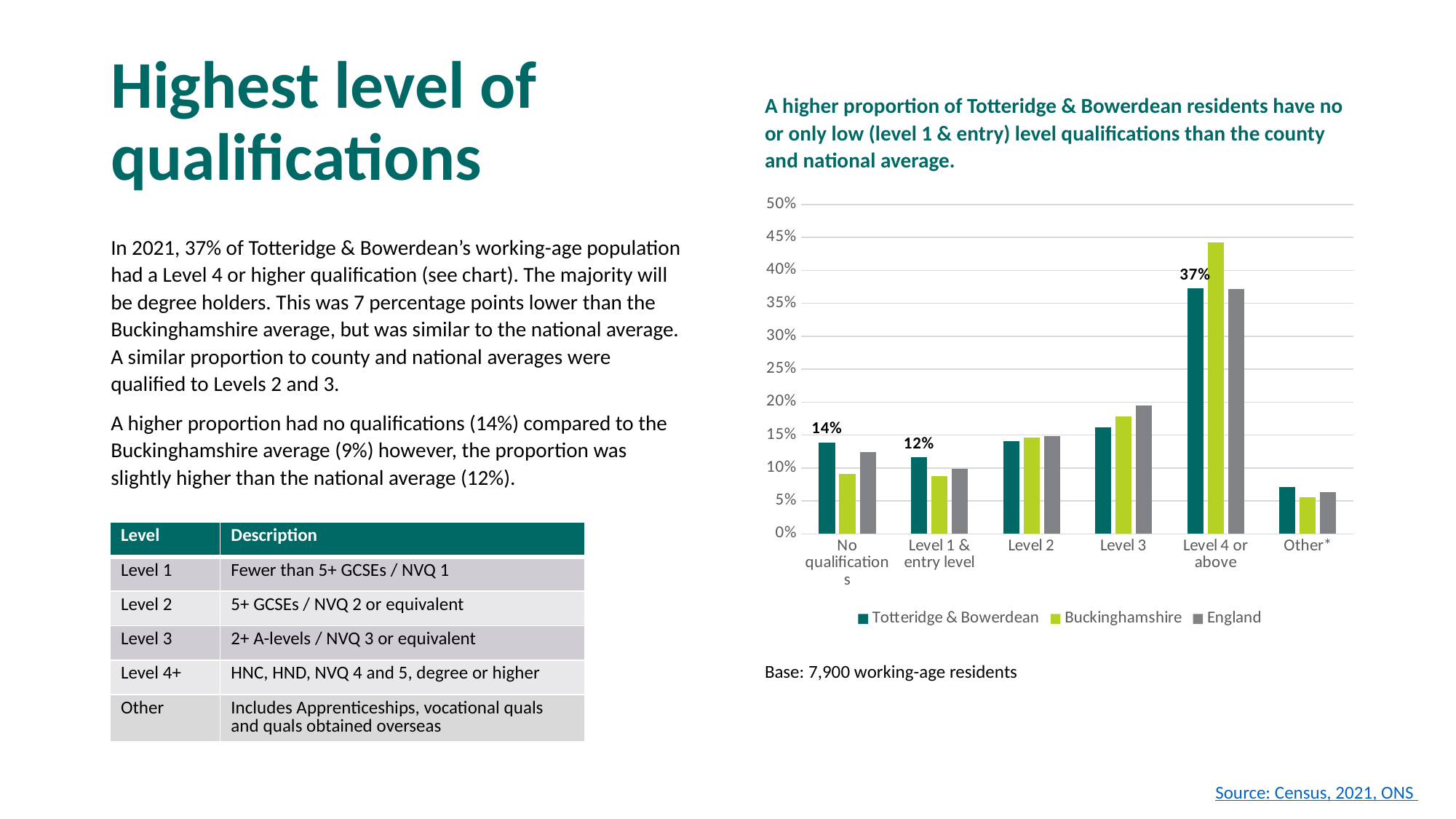
What is the value for Totteridge & Bowerdean in the Level 4 or above category? 37% In the Level 4 or above category, which is larger: Buckinghamshire or Totteridge & Bowerdean? Buckinghamshire What is the value for Totteridge & Bowerdean in the Level 1 & entry level category? 12% What is the difference in percentage points between Totteridge & Bowerdean's Level 4 or above value and its No qualifications value? 23 percentage points How many series does the chart legend list? 3 Is the value for Buckinghamshire in the Level 4 or above category greater or less than 40%? greater Which qualification category has the lowest value for Totteridge & Bowerdean? Other* In the No qualifications category, which is larger: Totteridge & Bowerdean or Buckinghamshire? Totteridge & Bowerdean What percentage of Totteridge & Bowerdean residents have no qualifications? 14% How many qualification categories are shown on the x axis of the chart? 6 Which qualification category has the highest value for Buckinghamshire? Level 4 or above Is the value for England in the No qualifications category greater or less than 10%? greater